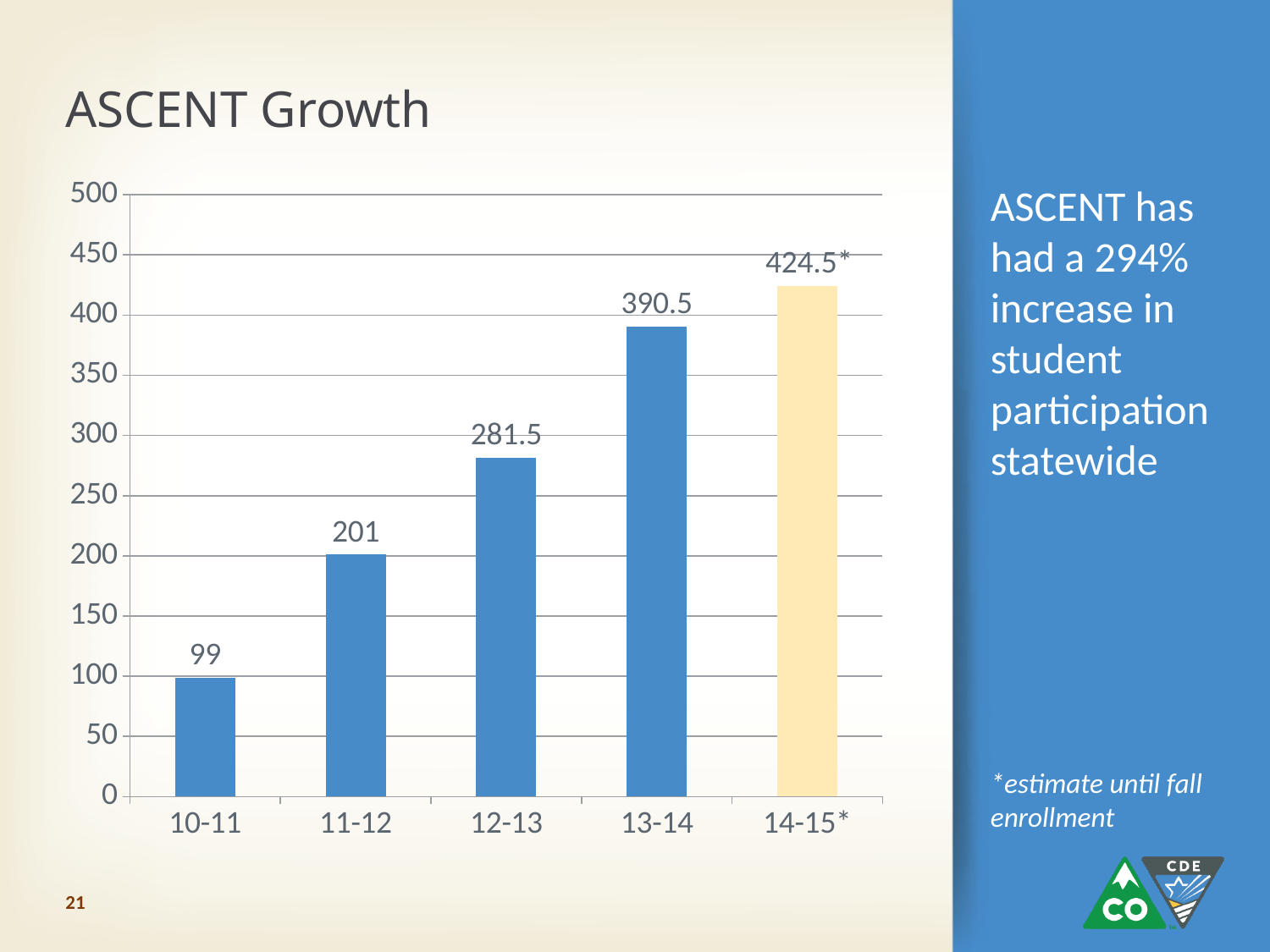
How many years are shown on the x axis? 5 Which year has the highest value? 14-15* Which is larger, the value for 12-13 or the value for 11-12? 12-13 What kind of chart is this? bar chart What is the value for 12-13? 281.5 What is the difference between the values for 11-12 and 10-11? 102 What is the difference between the values for 13-14 and 12-13? 109 What is the value for 13-14? 390.5 Do the values rise or fall from 10-11 to 14-15*? rise What is the value for 10-11? 99 Which year has the lowest value? 10-11 What is the value shown for 14-15*? 424.5*